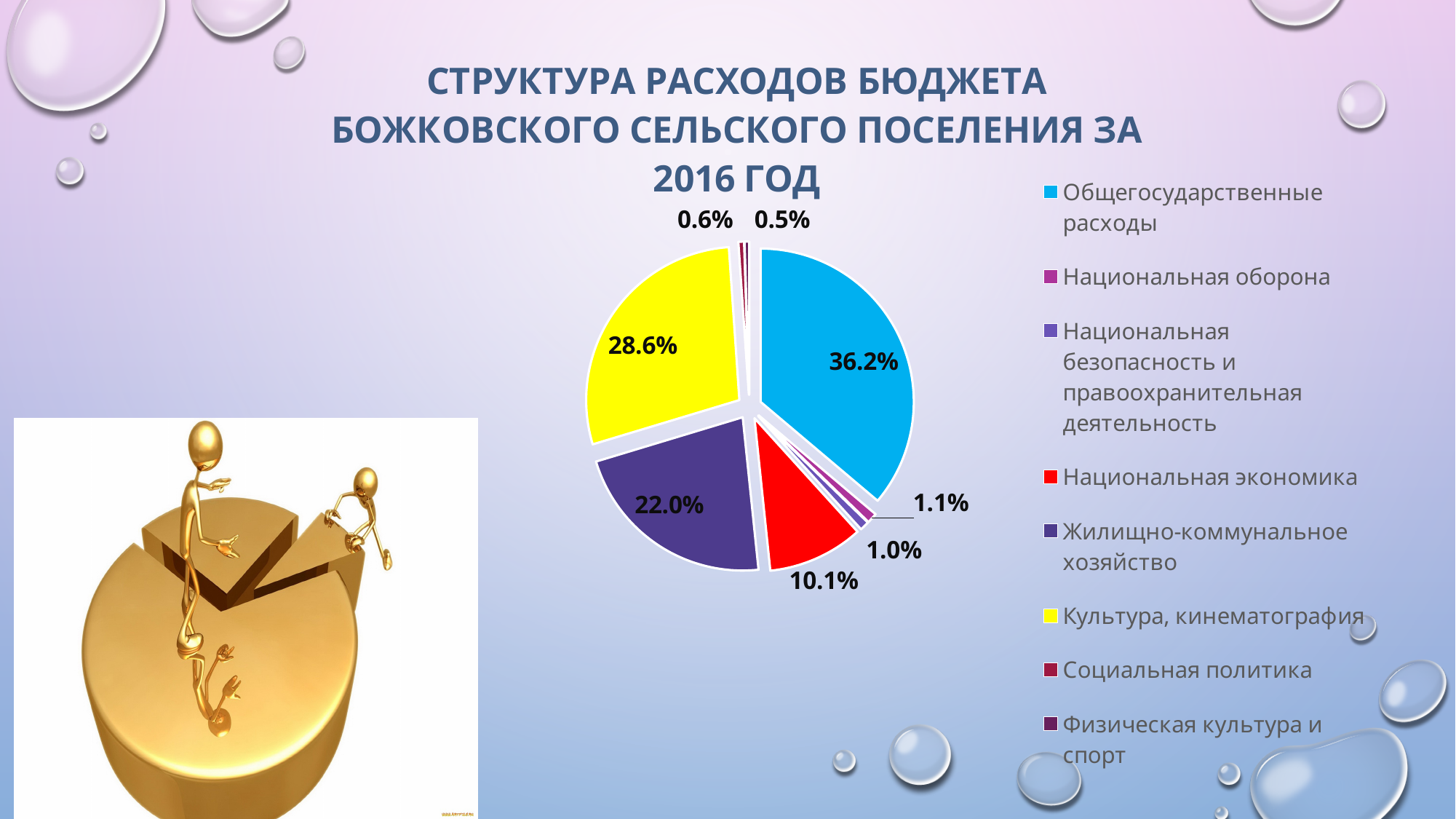
What share of budget expenditures is Культура, кинематография? 28.6% Which category has the largest share of the pie? Общегосударственные расходы What is the difference between the shares of Общегосударственные расходы and Культура, кинематография? 7.6% What share of budget expenditures is Жилищно-коммунальное хозяйство? 22.0% What colour is the slice for Национальная экономика? red Which category has the smallest share of the pie? Физическая культура и спорт What share of budget expenditures is Общегосударственные расходы? 36.2% Which is larger: the share of Жилищно-коммунальное хозяйство or Национальная экономика? Жилищно-коммунальное хозяйство What share of budget expenditures is Социальная политика? 0.6% How many categories does the legend list? 8 What type of chart is shown on the slide? pie chart What share of budget expenditures is Национальная экономика? 10.1%